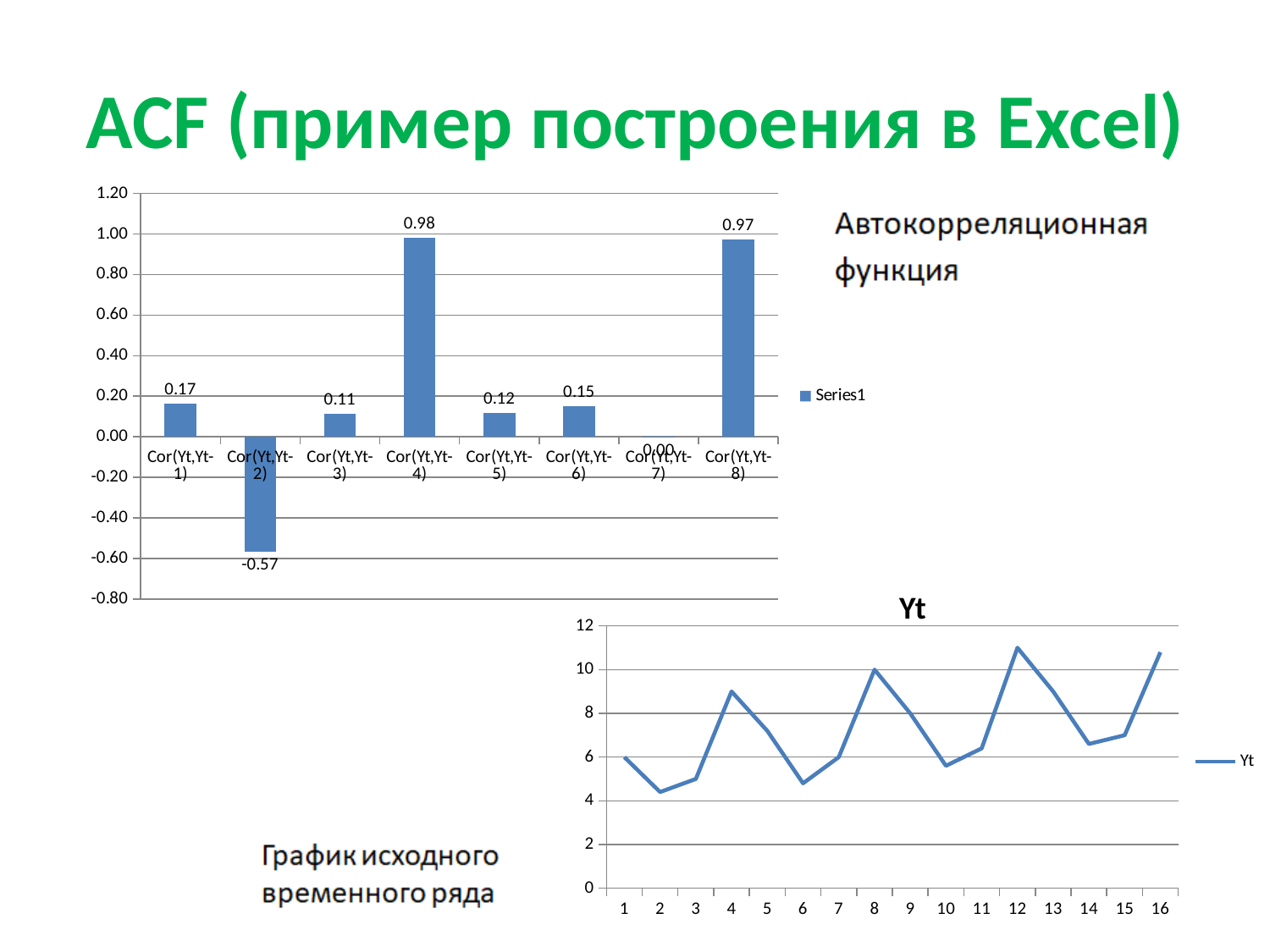
What series name does the legend of the bar chart on the left show? Series1 How many points are plotted in the chart titled Yt? 16 What kind of chart is the chart titled Yt? line chart In the bar chart on the left, what is the value for Cor(Yt,Yt-8)? 0.97 In the bar chart on the left, what is the value for Cor(Yt,Yt-4)? 0.98 How many categories are shown in the bar chart on the left? 8 In the bar chart on the left, which is larger: the value for Cor(Yt,Yt-1) or the value for Cor(Yt,Yt-6)? Cor(Yt,Yt-1) In the chart titled Yt, is the value at point 12 greater or less than 10? greater In the bar chart on the left, which category has the highest value? Cor(Yt,Yt-4) In the bar chart on the left, which category has the lowest value? Cor(Yt,Yt-2) In the bar chart on the left, what is the difference between the values for Cor(Yt,Yt-4) and Cor(Yt,Yt-8)? 0.01 In the bar chart on the left, what is the value for Cor(Yt,Yt-2)? -0.57